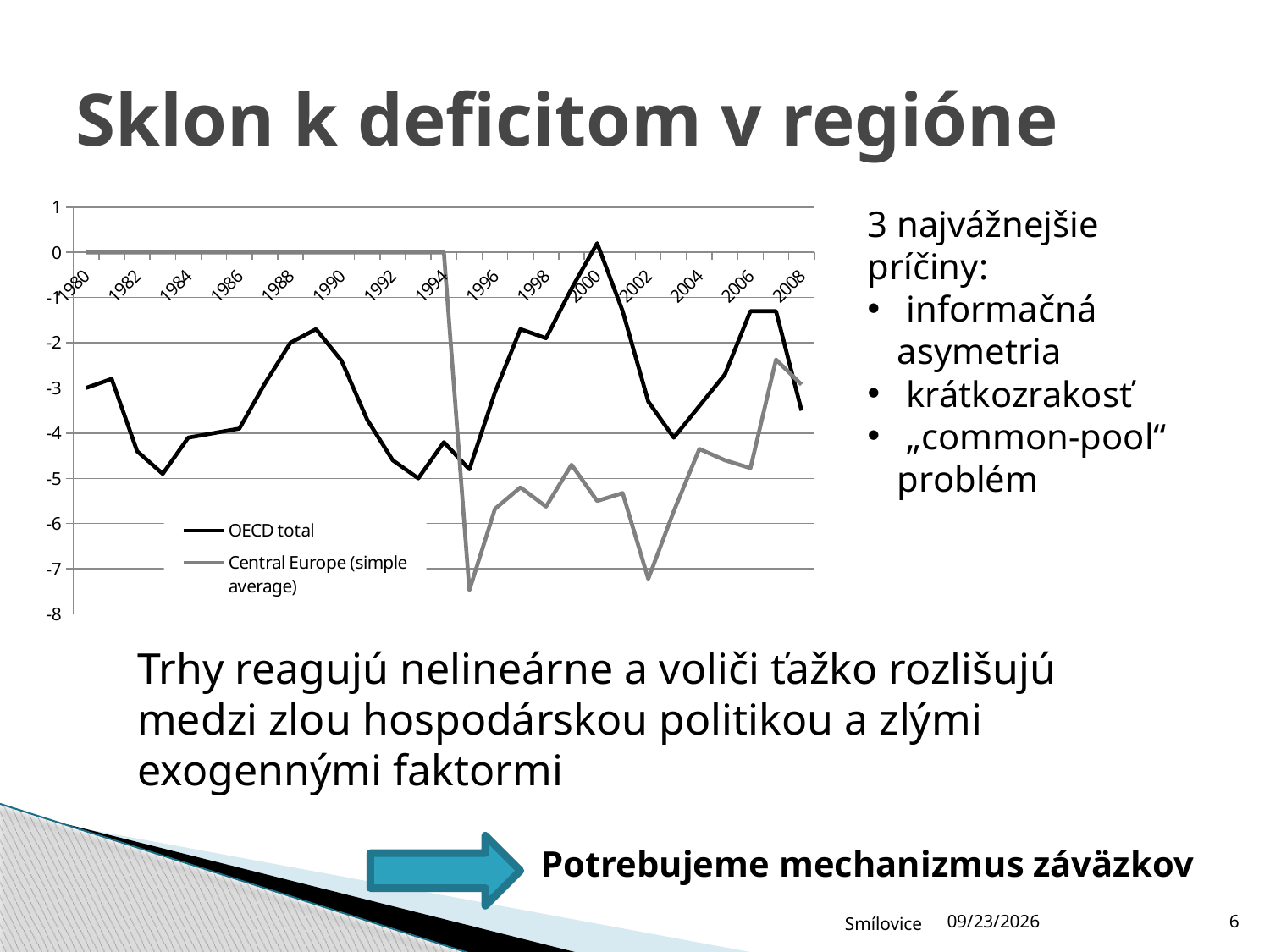
How many series does the chart legend list? 2 What are the two series named in the chart legend? OECD total; Central Europe (simple average) In 2002, which series has the higher value, OECD total or Central Europe (simple average)? OECD total Does the OECD total series rise or fall between 1997 and 2000? rise Is the value of Central Europe (simple average) in 1995 greater or less than -7? less In which year does the OECD total series reach its highest value? 2000 Is the value of Central Europe (simple average) in 2007 greater or less than -3? greater Which series is drawn with the black line? OECD total What kind of chart is shown on the slide? line chart Is the value of OECD total in 1983 greater or less than -4? less How many year labels are shown on the x axis? 15